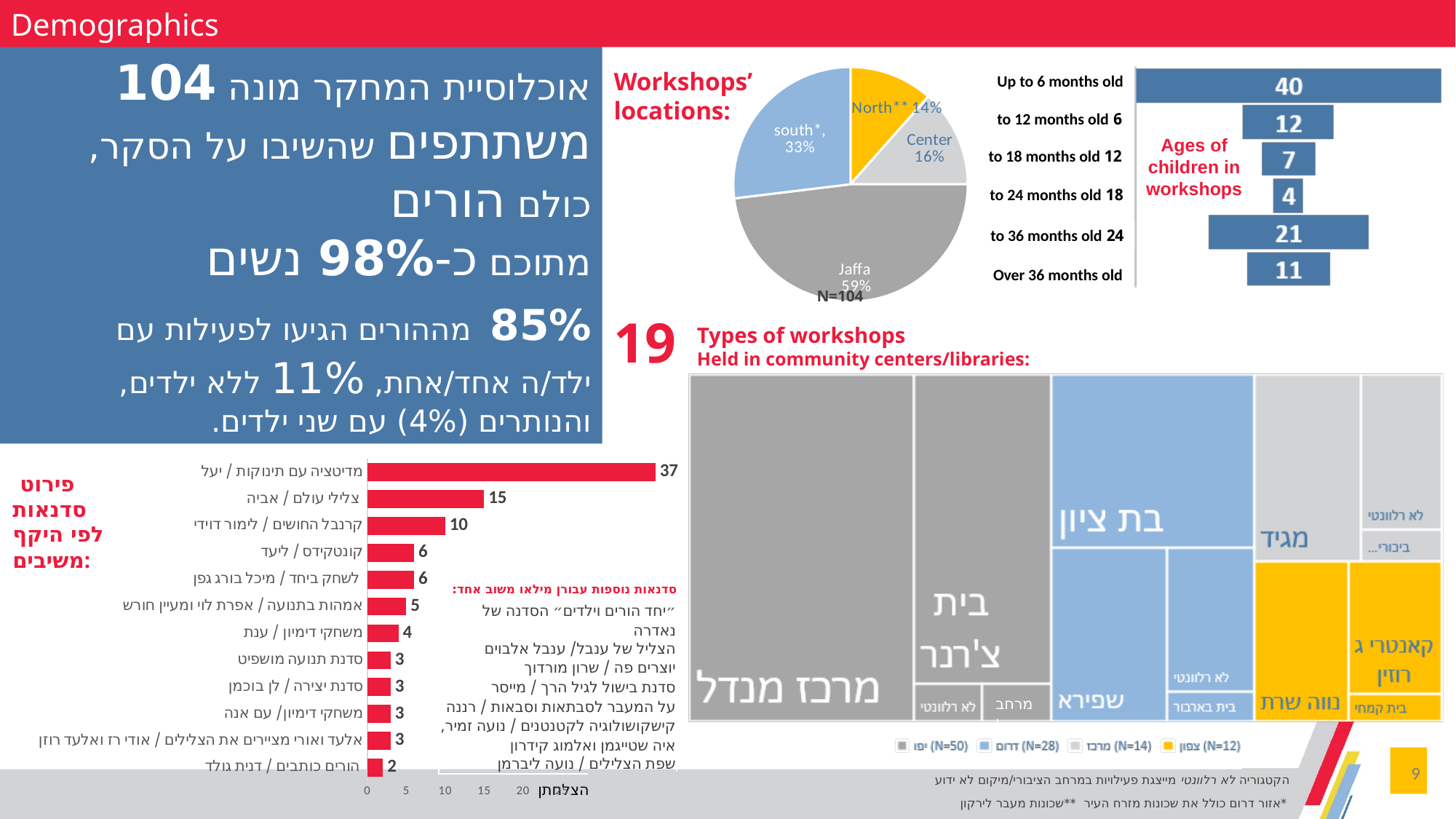
In the bottom-left bar chart of workshops by number of respondents, what is the value for 'מדיטציה עם תינוקות / יעל'? 37 How many age categories are shown in the 'Ages of children in workshops' chart? 6 In the 'Ages of children in workshops' chart, what is the difference between 'Up to 6 months old' and 'to 36 months old'? 19 In the 'Workshops' locations' pie chart, which location has the largest slice? Jaffa In the bottom-left bar chart of workshops by number of respondents, which workshop has the lowest value? הורים כותבים / דנית גולד In the 'Workshops' locations' pie chart, what is the N value printed below the chart? N=104 In the 'Ages of children in workshops' chart, what is the value for 'Up to 6 months old'? 40 In the bottom-left bar chart of workshops by number of respondents, what is the difference between 'מדיטציה עם תינוקות / יעל' and 'צלילי עולם / אביה'? 22 What kind of chart is the 'Ages of children in workshops' chart? bar chart In the 'Ages of children in workshops' chart, which age group has the lowest value? to 24 months old In the 'Workshops' locations' pie chart, what percentage is shown for Jaffa? 59% How many series does the legend of the 'Types of workshops' treemap list? 4